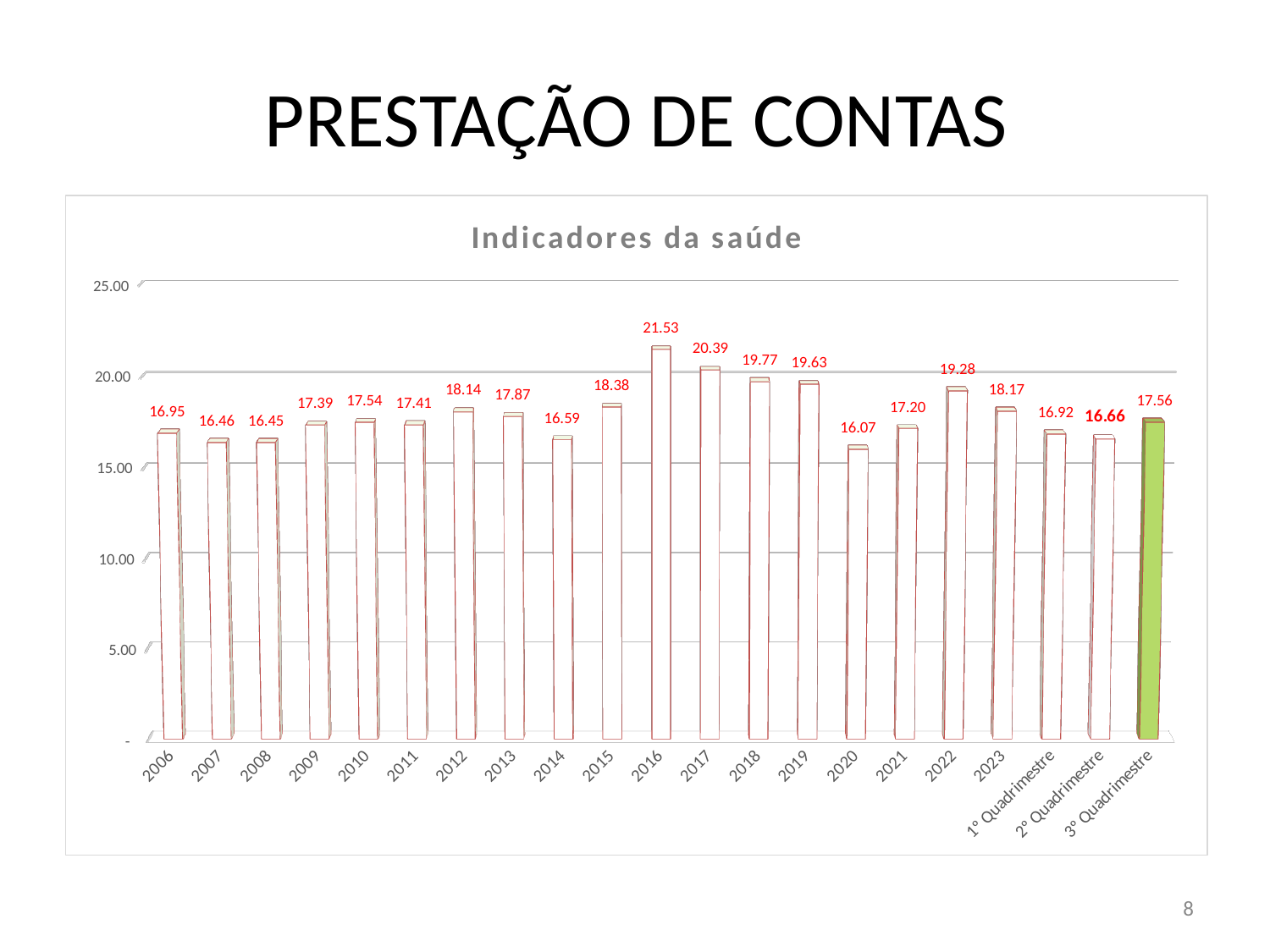
What is the value for 2020 in the Indicadores da saúde chart? 16.07 Which category has the lowest value in the Indicadores da saúde chart? 2020 Which is larger in the Indicadores da saúde chart, the value for 2022 or the value for 2023? 2022 What is the value for 2016 in the Indicadores da saúde chart? 21.53 How many categories are shown on the x axis of the Indicadores da saúde chart? 21 What is the difference between the values for 2016 and 2017 in the Indicadores da saúde chart? 1.14 What is the title of the chart on the slide? Indicadores da saúde What kind of chart is the Indicadores da saúde chart? Bar chart What is the difference between the values for 3° Quadrimestre and 2° Quadrimestre in the Indicadores da saúde chart? 0.90 What is the value for 3° Quadrimestre in the Indicadores da saúde chart? 17.56 Which category has the highest value in the Indicadores da saúde chart? 2016 What is the value for 2012 in the Indicadores da saúde chart? 18.14